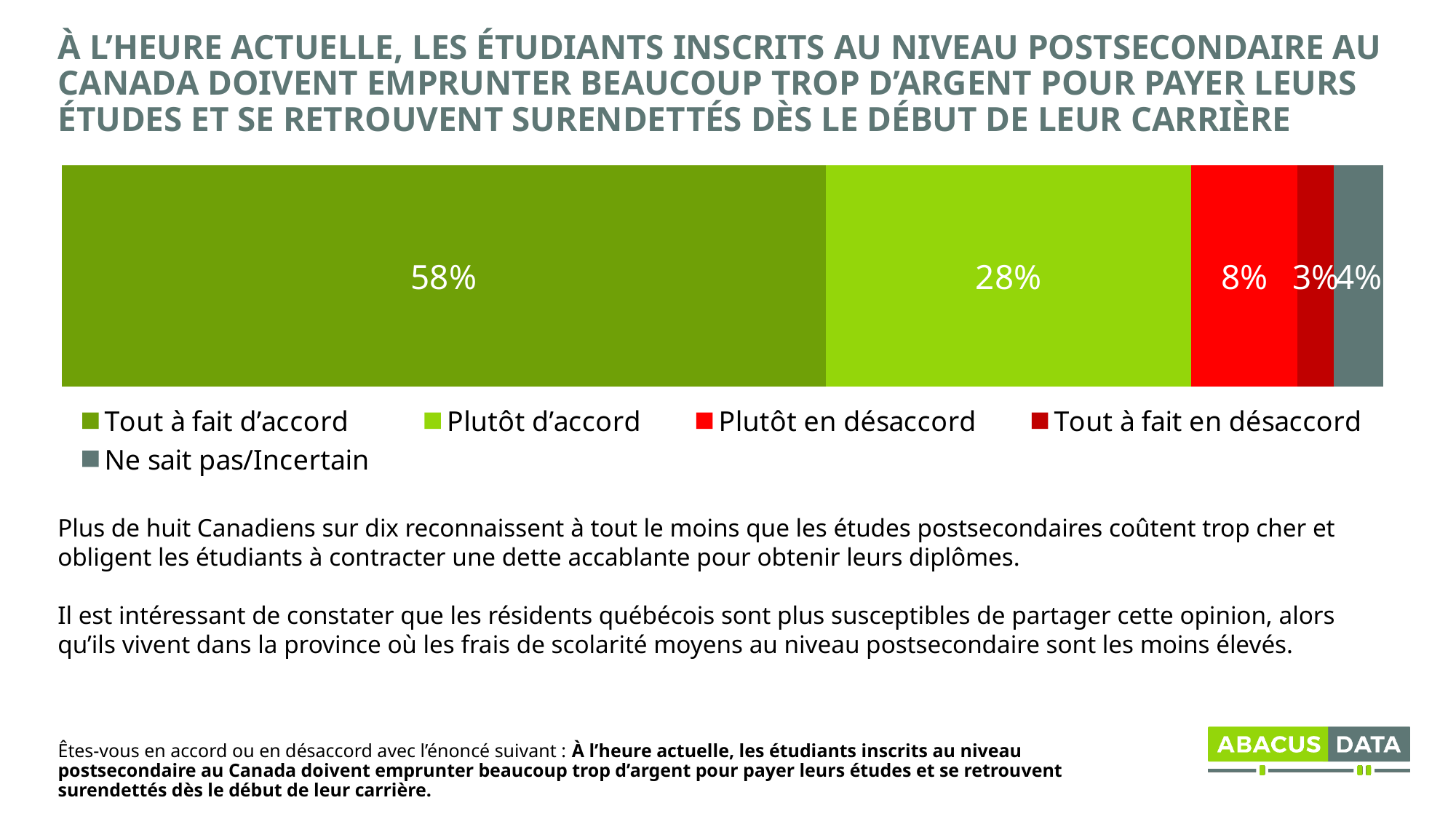
What percentage of respondents answered "Tout à fait d'accord"? 58% What is the combined percentage of "Tout à fait d'accord" and "Plutôt d'accord"? 86% What percentage of respondents answered "Plutôt d'accord"? 28% What percentage of respondents answered "Tout à fait en désaccord"? 3% Which response category has the largest share? Tout à fait d'accord What percentage of respondents answered "Ne sait pas/Incertain"? 4% What percentage of respondents answered "Plutôt en désaccord"? 8% Which response category has the smallest share? Tout à fait en désaccord Which is larger: the share for "Plutôt en désaccord" or for "Ne sait pas/Incertain"? Plutôt en désaccord How many response categories does the legend list? 5 What is the difference between the "Tout à fait d'accord" and "Plutôt d'accord" percentages? 30 percentage points What type of chart is shown on the slide? Stacked bar chart